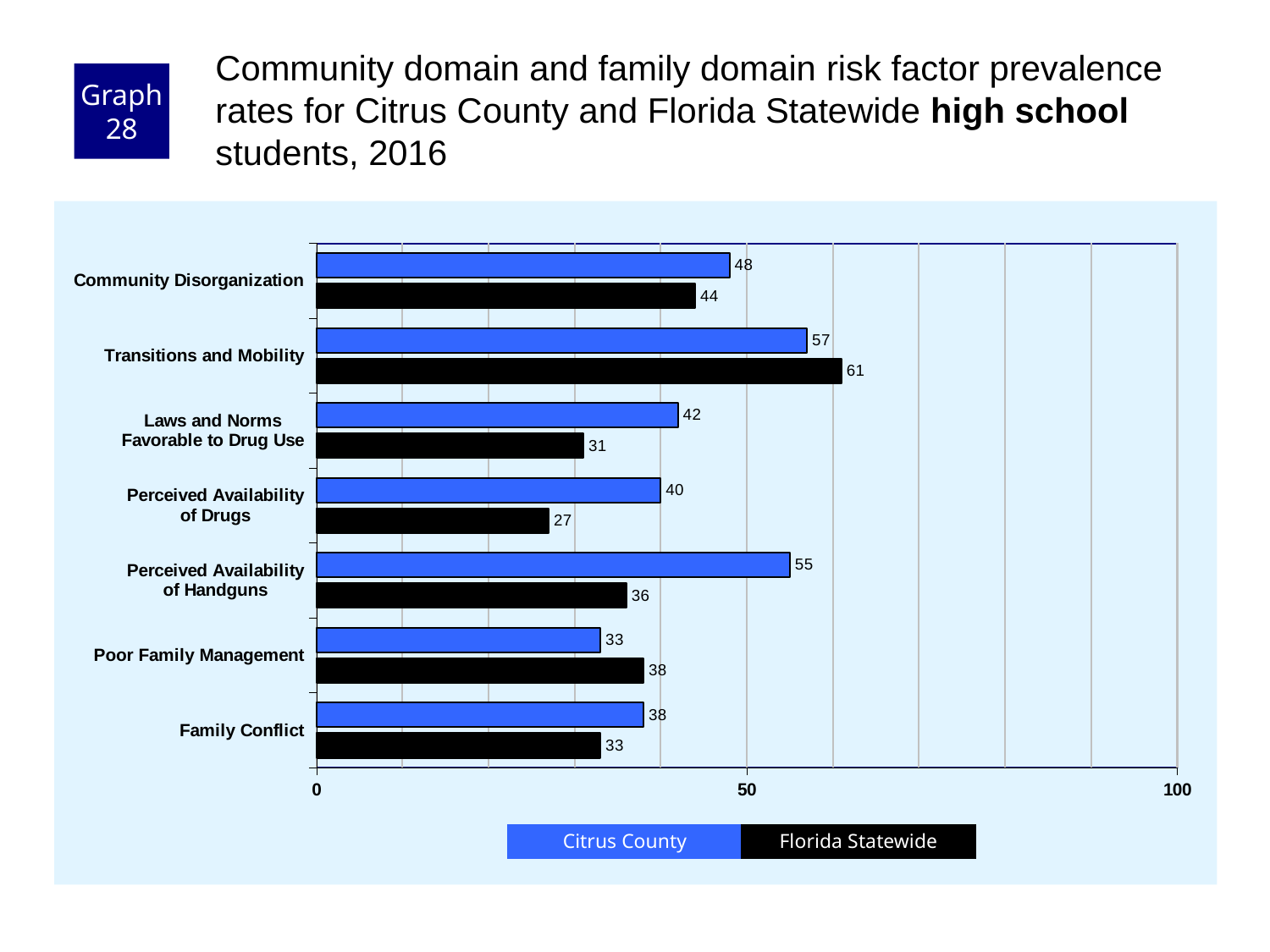
Which risk factor has the lowest Florida Statewide value? Perceived Availability of Drugs What is the Citrus County value for Community Disorganization? 48 Is the Citrus County value for Perceived Availability of Handguns greater or less than 50? greater What is the Florida Statewide value for Perceived Availability of Drugs? 27 What is the difference between the Citrus County and Florida Statewide values for Perceived Availability of Handguns? 19 What is the Florida Statewide value for Transitions and Mobility? 61 How many risk factor categories are shown on the chart? 7 Which risk factor has the highest Citrus County value? Transitions and Mobility Which is larger for Poor Family Management: the Citrus County value or the Florida Statewide value? Florida Statewide What kind of chart is shown on the slide? Bar chart Which colour represents Florida Statewide in the chart? Black How many series does the legend list? 2